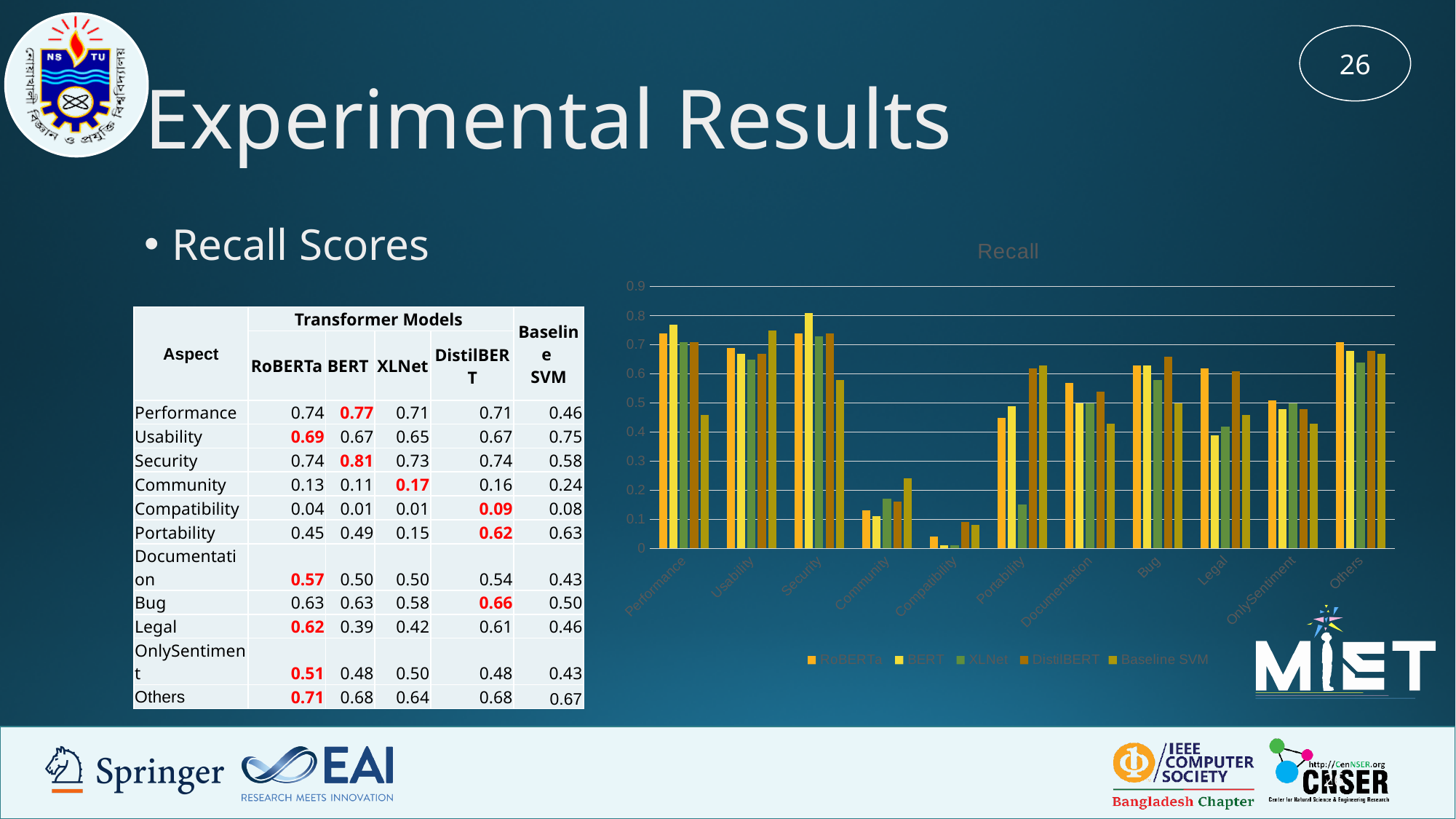
What is the title of the chart? Recall What is the recall value for BERT on the Security aspect? 0.81 Which model has the highest recall on the Legal aspect? RoBERTa Which aspect has the lowest recall values across all models? Compatibility How many aspect categories are shown along the x axis of the chart? 11 What is the difference between the RoBERTa and BERT recall values for Legal? 0.23 How many series does the chart legend list? 5 What is the recall value for Baseline SVM on the Usability aspect? 0.75 Which is larger, the DistilBERT recall for Portability or the XLNet recall for Portability? DistilBERT What kind of chart is shown on the slide? bar chart Is the Baseline SVM recall value for Community greater or less than 0.3? less Is the BERT recall value for Security greater or less than 0.8? greater